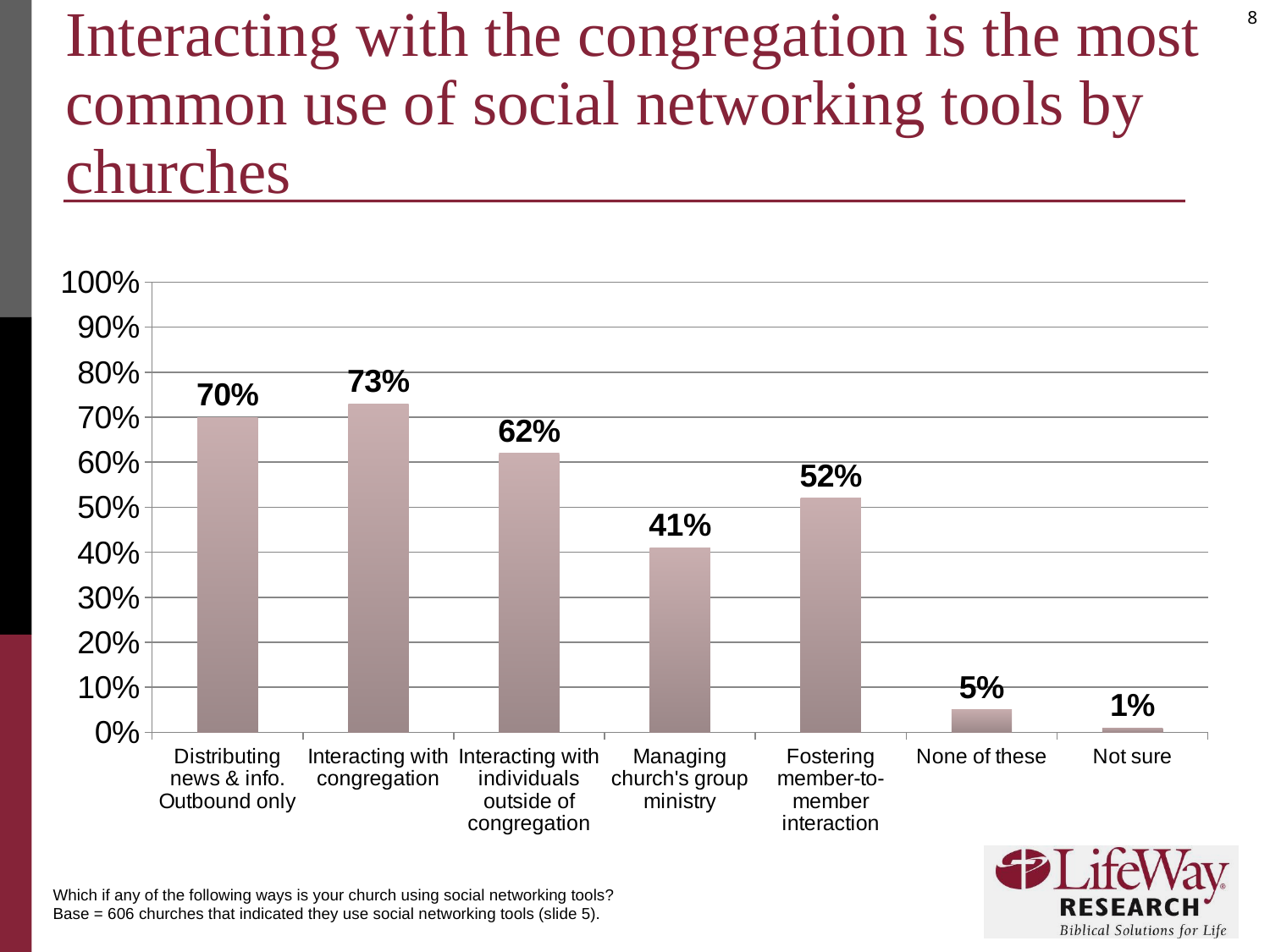
Which category has the highest value? Interacting with congregation Which category has the lowest value? Not sure Which is larger: 'Fostering member-to-member interaction' or 'Managing church's group ministry'? Fostering member-to-member interaction What is the value for 'Distributing news & info. Outbound only'? 70% What percentage is shown for 'Fostering member-to-member interaction'? 52% What percentage of churches use social networking tools for interacting with the congregation? 73% What is the value for 'Managing church's group ministry'? 41% What is the difference between 'Distributing news & info. Outbound only' and 'Interacting with individuals outside of congregation'? 8% What is the maximum value shown on the y axis? 100% Is the value for 'None of these' greater or less than 10%? less What kind of chart is shown on the slide? Bar chart How many categories are shown on the chart? 7